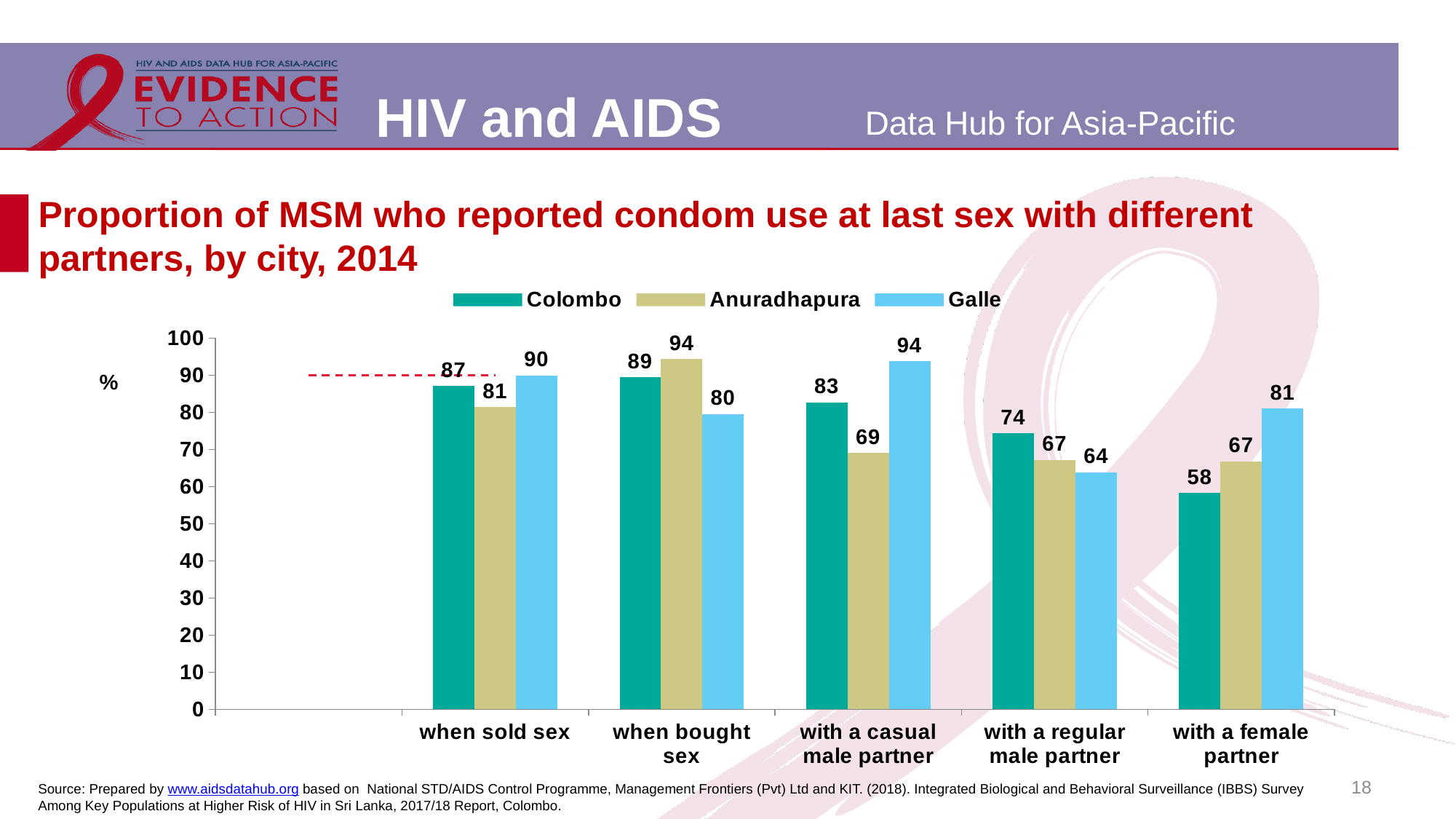
Which city is represented by the light blue bars in the legend? Galle What is the value for Anuradhapura when bought sex? 94 What kind of chart is shown on the slide? Bar chart What is the difference between Galle and Anuradhapura with a casual male partner? 25 Which city has the highest value with a female partner? Galle How many partner-type categories are shown on the x axis? 5 Which city has the lowest value with a regular male partner? Galle Which is larger: Colombo when bought sex or Galle when bought sex? Colombo when bought sex What is the value for Galle with a casual male partner? 94 How many series does the legend list? 3 What is the value for Colombo when sold sex? 87 What is the value for Colombo with a female partner? 58